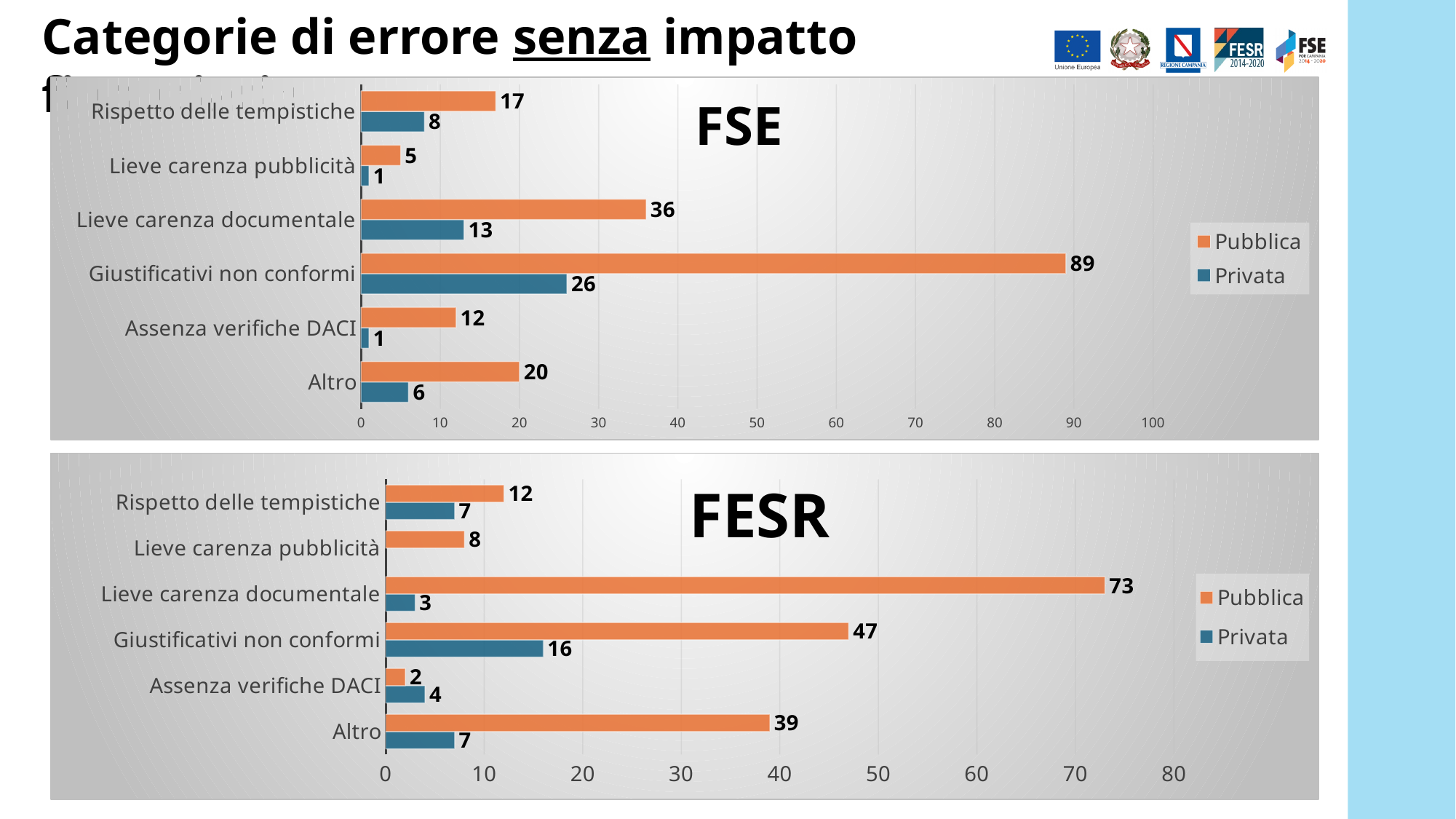
In the FESR chart, what is the difference between the Pubblica values for Lieve carenza documentale and Altro? 34 In the FESR chart, what is the Privata value for Giustificativi non conformi? 16 In the FESR chart, which category has the lowest Pubblica value? Assenza verifiche DACI In the FSE chart, what is the difference between the Pubblica and Privata values for Giustificativi non conformi? 63 In the FESR chart, which is larger for Assenza verifiche DACI: the Pubblica value or the Privata value? Privata How many series does the legend of the FSE chart list? 2 In the FSE chart, what is the Privata value for Lieve carenza documentale? 13 How many categories are shown on the FESR chart? 6 In the FESR chart, what is the Pubblica value for Lieve carenza documentale? 73 In the FSE chart, what is the Pubblica value for Giustificativi non conformi? 89 What kind of chart is the FESR chart? Bar chart In the FSE chart, which category has the highest Pubblica value? Giustificativi non conformi